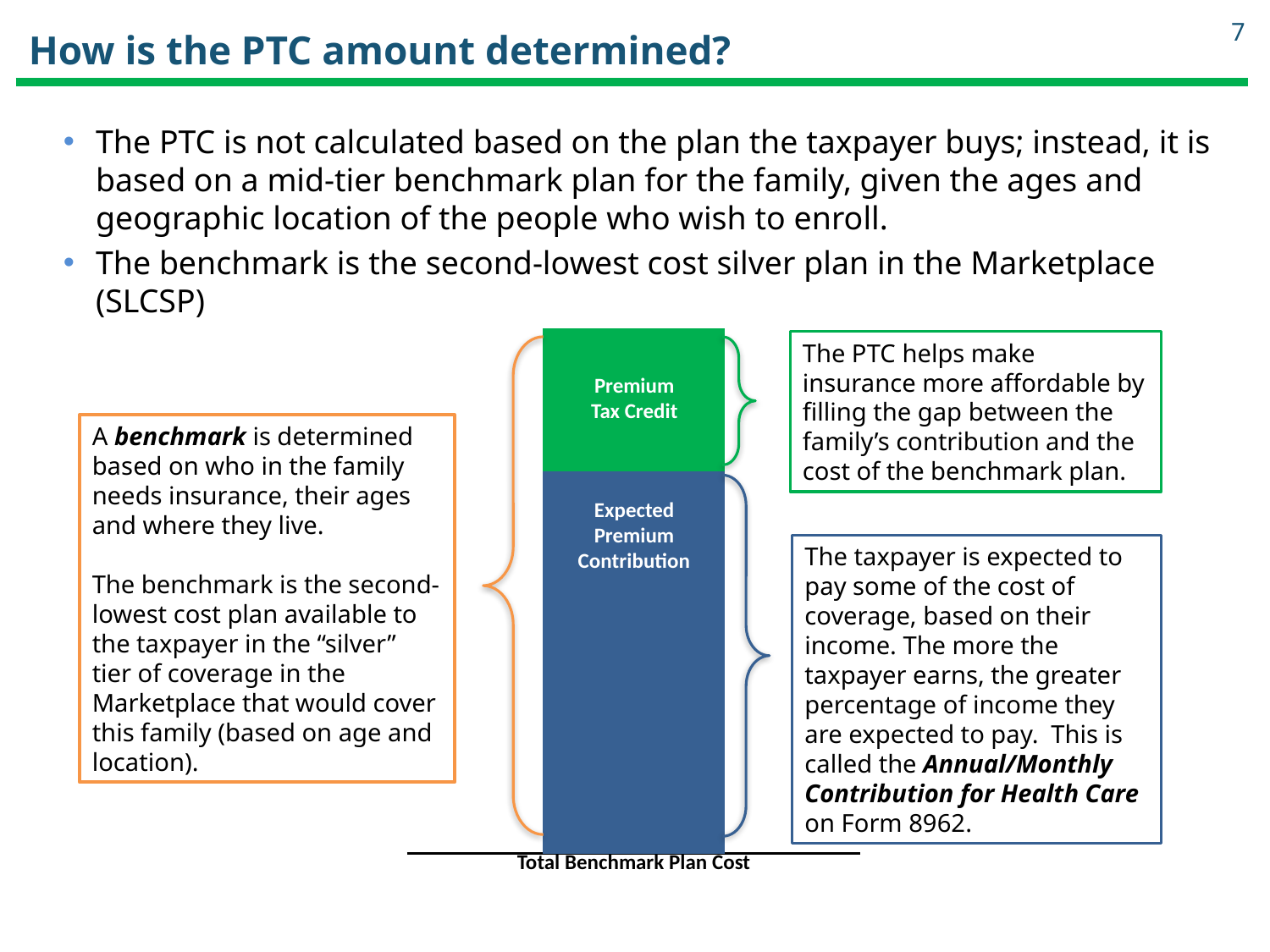
How many segments make up the stacked bar on the slide? 2 Which segment of the stacked bar is larger, Premium Tax Credit or Expected Premium Contribution? Expected Premium Contribution Which segment of the stacked bar is the smallest? Premium Tax Credit What colour is the Premium Tax Credit segment of the stacked bar? green Which segment of the stacked bar is the largest? Expected Premium Contribution What kind of chart is shown in the middle of the slide? stacked bar chart What does the full height of the stacked bar represent, according to the label beneath it? Total Benchmark Plan Cost